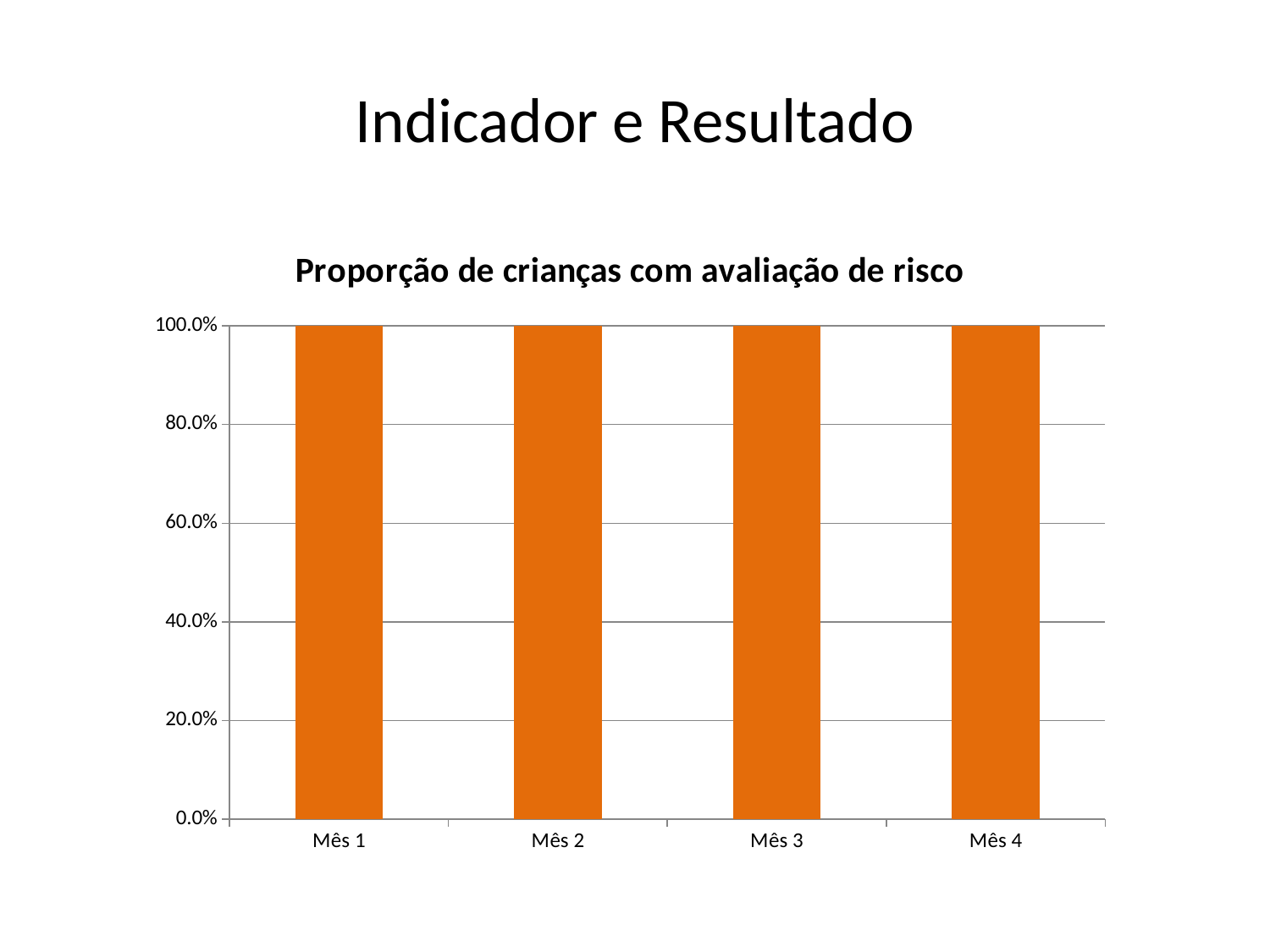
What is the value for Mês 4? 100.0% Is the value for Mês 2 greater or less than 80.0%? greater What is the value for Mês 1? 100.0% What is the difference between the values for Mês 1 and Mês 2? 0.0% What type of chart is shown on the slide? bar chart What colour are the bars in the chart? orange Do the values rise, fall or stay the same from Mês 1 to Mês 4? stay the same How many categories are shown on the x axis of the chart? 4 What is the title of the chart? Proporção de crianças com avaliação de risco Is the value for Mês 4 greater or less than 60.0%? greater What is the value for Mês 3? 100.0% What is the highest value shown on the y axis of the chart? 100.0%